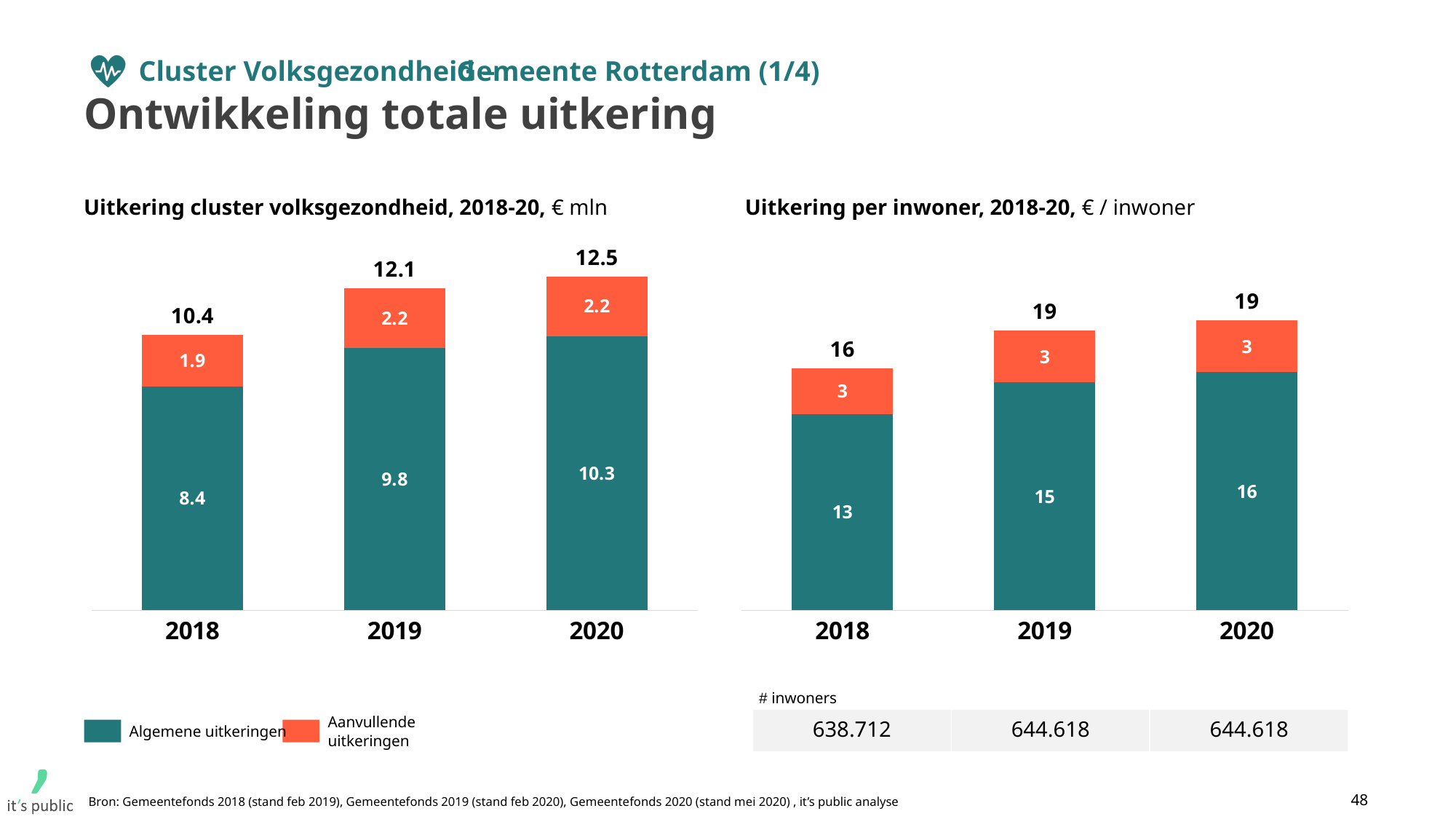
In the chart 'Uitkering per inwoner, 2018-20', what is the value of Algemene uitkeringen for 2020? 16 How many series does the legend list for the chart 'Uitkering cluster volksgezondheid, 2018-20'? 2 In the chart 'Uitkering cluster volksgezondheid, 2018-20', which year has the highest total? 2020 In the chart 'Uitkering cluster volksgezondheid, 2018-20', what is the total of the stacked bar for 2020? 12.5 How many years are shown on the x axis of the chart 'Uitkering cluster volksgezondheid, 2018-20'? 3 In the chart 'Uitkering per inwoner, 2018-20', is the Algemene uitkeringen value larger for 2019 or for 2020? 2020 In the chart 'Uitkering cluster volksgezondheid, 2018-20', do the totals rise or fall from 2018 to 2020? rise In the chart 'Uitkering per inwoner, 2018-20', what is the total of the stacked bar for 2018? 16 In the chart 'Uitkering cluster volksgezondheid, 2018-20', what is the value of Aanvullende uitkeringen for 2018? 1.9 In the chart 'Uitkering per inwoner, 2018-20', which year has the lowest total? 2018 In the chart 'Uitkering cluster volksgezondheid, 2018-20', what is the value of Algemene uitkeringen for 2019? 9.8 In the chart 'Uitkering cluster volksgezondheid, 2018-20', what is the difference between the Algemene uitkeringen values for 2020 and 2018? 1.9